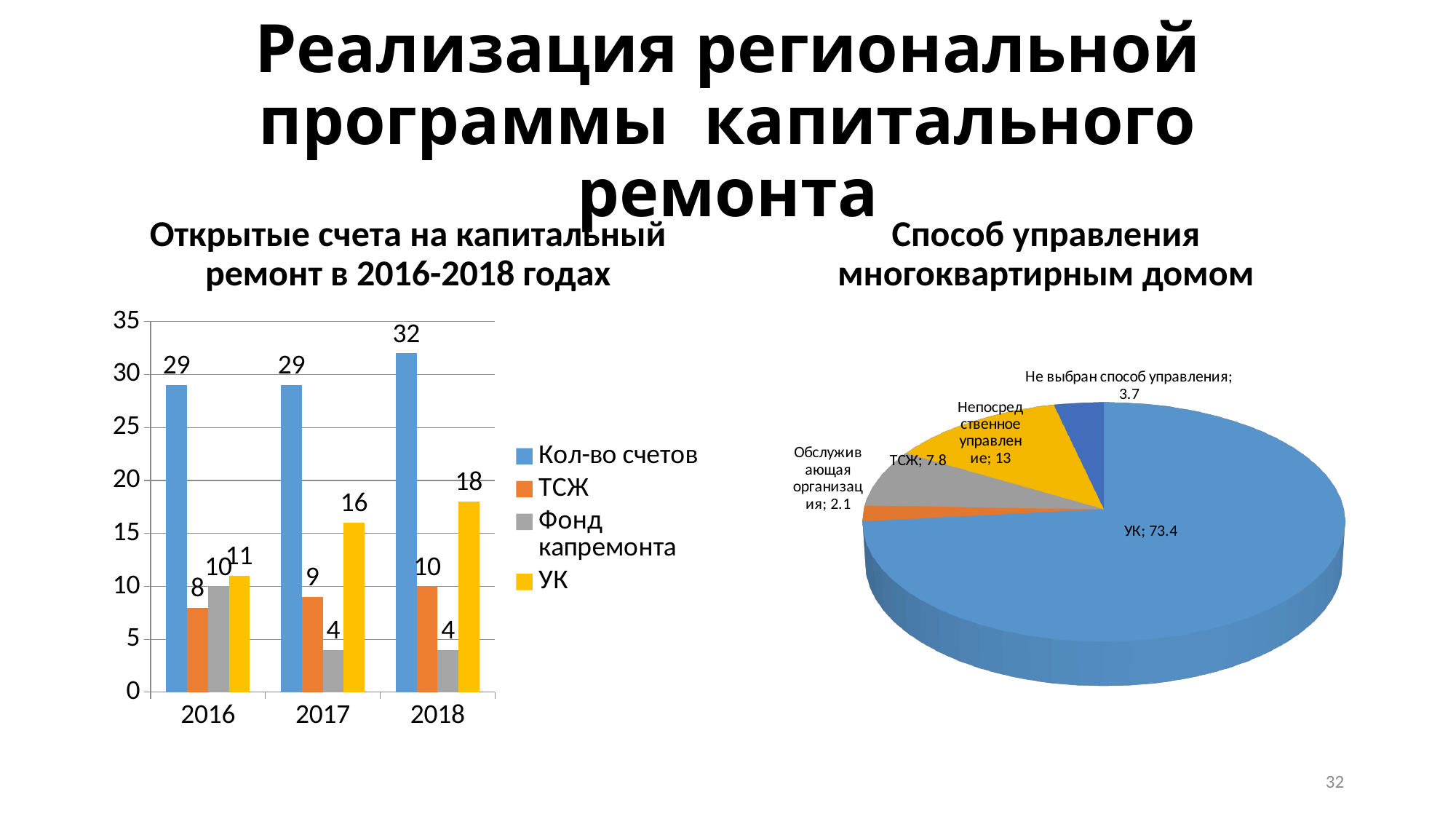
In the chart 'Открытые счета на капитальный ремонт в 2016-2018 годах', which is larger in 2017: 'ТСЖ' or 'Фонд капремонта'? ТСЖ In the chart 'Открытые счета на капитальный ремонт в 2016-2018 годах', does the value of 'УК' rise or fall from 2016 to 2018? rise In the chart 'Открытые счета на капитальный ремонт в 2016-2018 годах', what is the value of 'УК' for 2017? 16 In the chart 'Открытые счета на капитальный ремонт в 2016-2018 годах', what is the value of 'Кол-во счетов' for 2018? 32 In the chart 'Открытые счета на капитальный ремонт в 2016-2018 годах', what is the value of 'Фонд капремонта' for 2016? 10 What kind of chart is 'Способ управления многоквартирным домом'? pie chart In the chart 'Открытые счета на капитальный ремонт в 2016-2018 годах', in which year is the value of 'ТСЖ' highest? 2018 In the chart 'Открытые счета на капитальный ремонт в 2016-2018 годах', how many series does the legend list? 4 In the chart 'Способ управления многоквартирным домом', what is the value for 'Непосредственное управление'? 13 In the chart 'Способ управления многоквартирным домом', how many slices does the pie have? 5 In the chart 'Открытые счета на капитальный ремонт в 2016-2018 годах', what is the difference between the 'УК' values for 2018 and 2016? 7 In the chart 'Способ управления многоквартирным домом', which category has the smallest slice? Обслуживающая организация